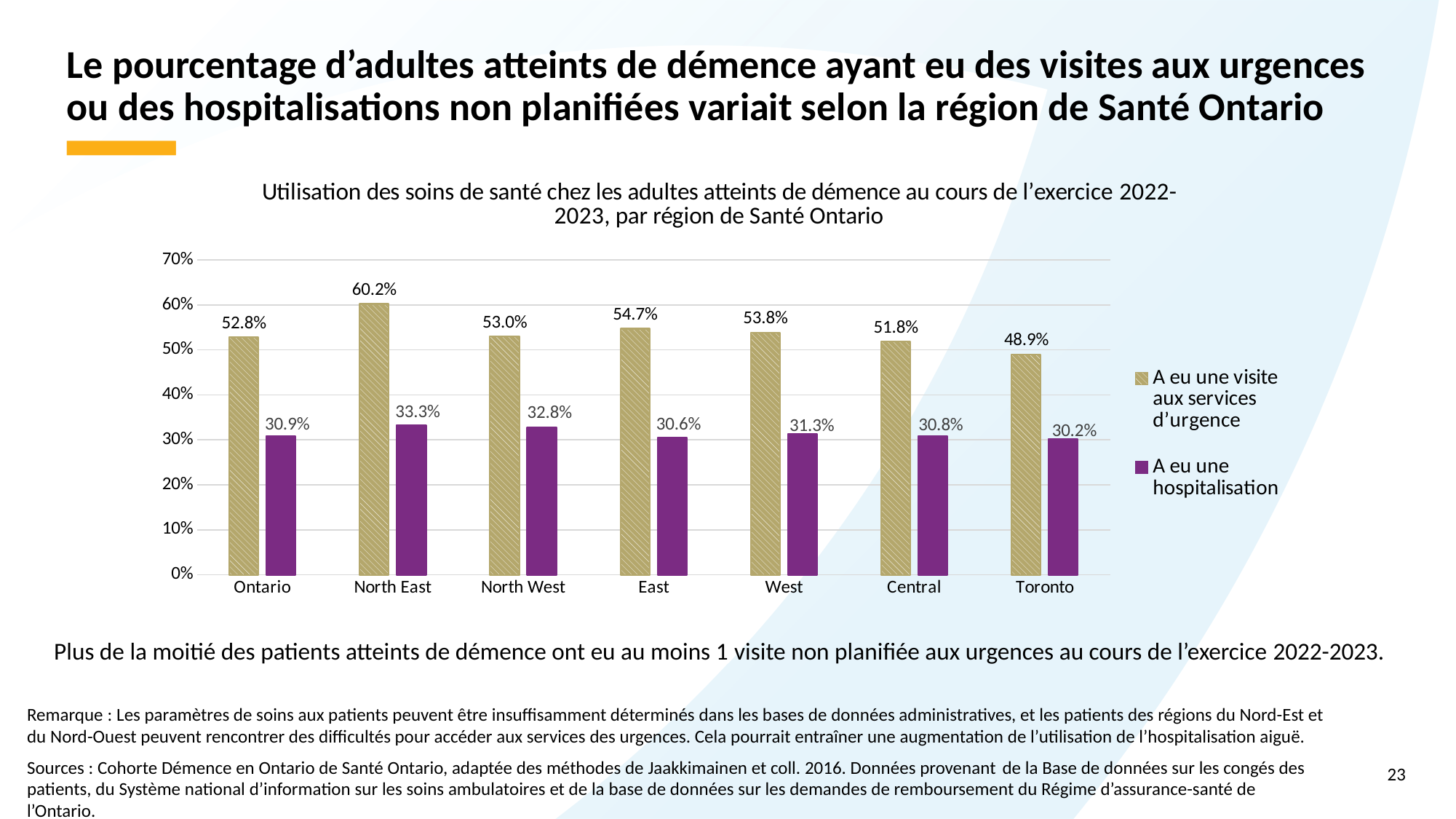
What is the difference between the 'A eu une visite aux services d'urgence' values for North East and Toronto? 11.3% What kind of chart is shown on the slide? bar chart How many series does the legend list? 2 Which is larger: the 'A eu une hospitalisation' value for North East or for West? North East Which region has the highest value for 'A eu une visite aux services d'urgence'? North East Which region has the lowest value for 'A eu une hospitalisation'? Toronto What is the value for 'A eu une visite aux services d'urgence' in Ontario? 52.8% What colour are the bars for 'A eu une hospitalisation'? purple Is the value for 'A eu une visite aux services d'urgence' in Toronto greater or less than 50%? less What is the value for 'A eu une visite aux services d'urgence' in North East? 60.2% What is the value for 'A eu une hospitalisation' in Toronto? 30.2% How many regions are shown on the x axis? 7